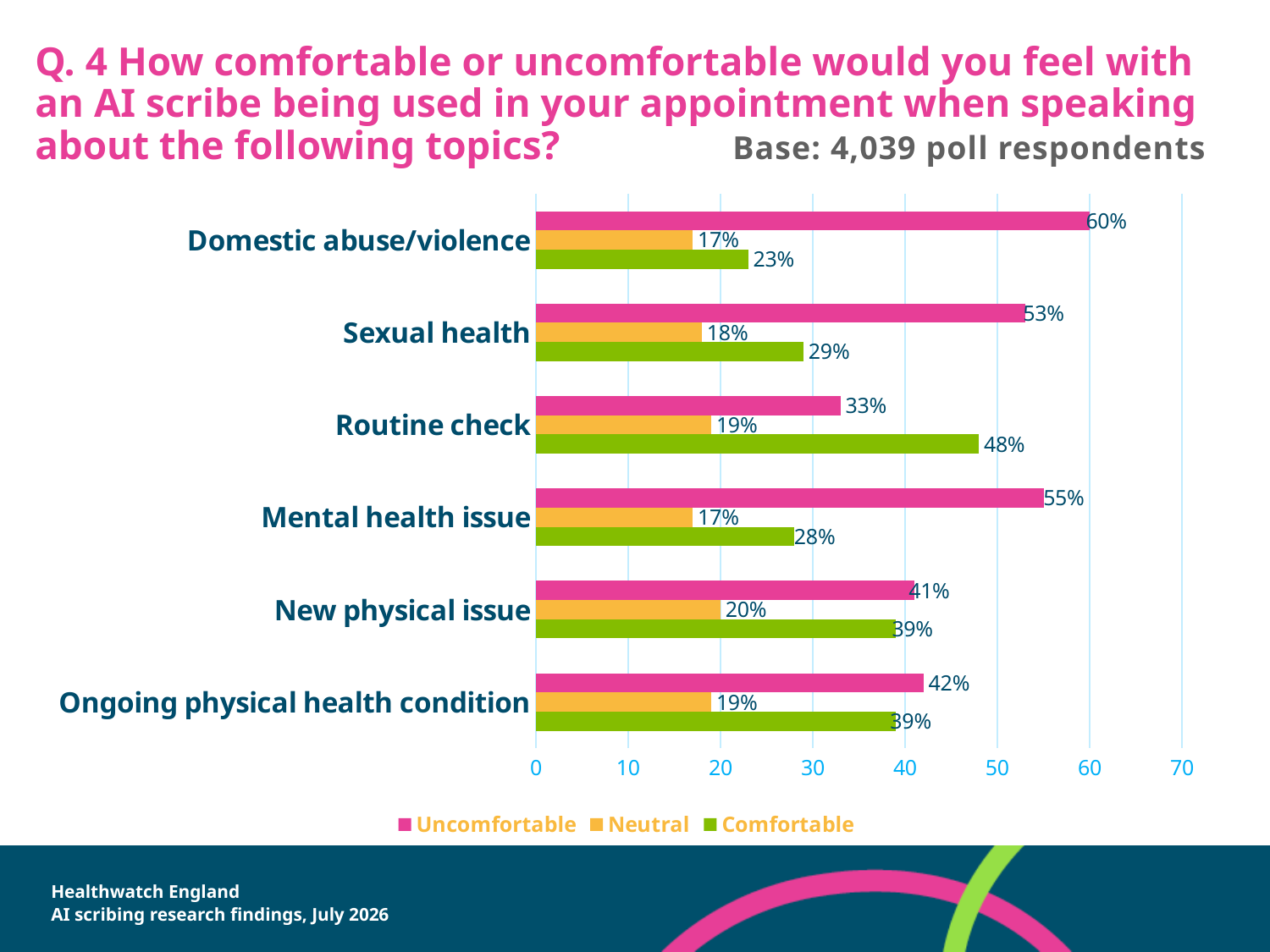
What is the Neutral value for New physical issue? 20% Which topic has the highest Uncomfortable percentage? Domestic abuse/violence How many series does the legend list? 3 What is the Comfortable value for Routine check? 48% Which is larger for Mental health issue: the Uncomfortable or the Comfortable percentage? Uncomfortable What is the base number of poll respondents stated on the slide? 4,039 How many topics are shown on the chart? 6 What is the difference between the Uncomfortable and Comfortable percentages for Sexual health? 24% What kind of chart is shown on the slide? Bar chart Which topic has the lowest Comfortable percentage? Domestic abuse/violence What percentage of respondents said they would feel uncomfortable with an AI scribe when speaking about domestic abuse/violence? 60% Which colour represents the Neutral series in the chart? Orange